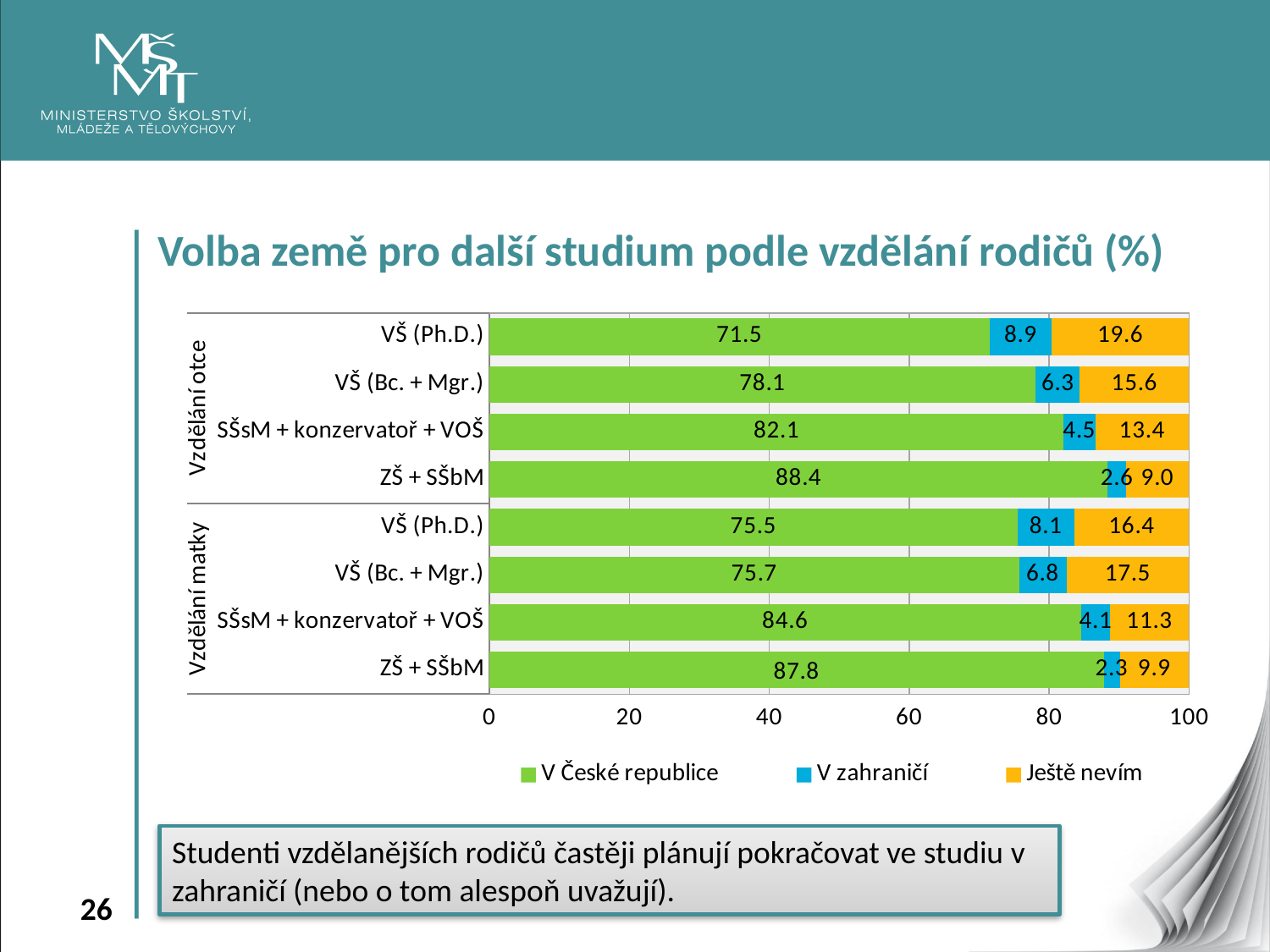
How many bars (categories) are plotted in the chart in total? 8 Which is larger: the 'Ještě nevím' value for VŠ (Ph.D.) under Vzdělání otce or for VŠ (Bc. + Mgr.) under Vzdělání matky? VŠ (Ph.D.) under Vzdělání otce How many series does the legend list? 3 What is the value of 'Ještě nevím' for SŠsM + konzervatoř + VOŠ under Vzdělání otce? 13.4 Which category under Vzdělání otce has the highest 'V České republice' value? ZŠ + SŠbM What is the difference between the 'V zahraničí' values for VŠ (Ph.D.) under Vzdělání otce and under Vzdělání matky? 0.8 What is the value of 'V České republice' for VŠ (Ph.D.) under Vzdělání otce? 71.5 What is the total of the stacked bar for ZŠ + SŠbM under Vzdělání otce? 100.0 What kind of chart is shown on the slide? stacked bar chart What is the title of the chart? Volba země pro další studium podle vzdělání rodičů (%) What is the value of 'V zahraničí' for VŠ (Bc. + Mgr.) under Vzdělání matky? 6.8 Which category under Vzdělání matky has the lowest 'V zahraničí' value? ZŠ + SŠbM